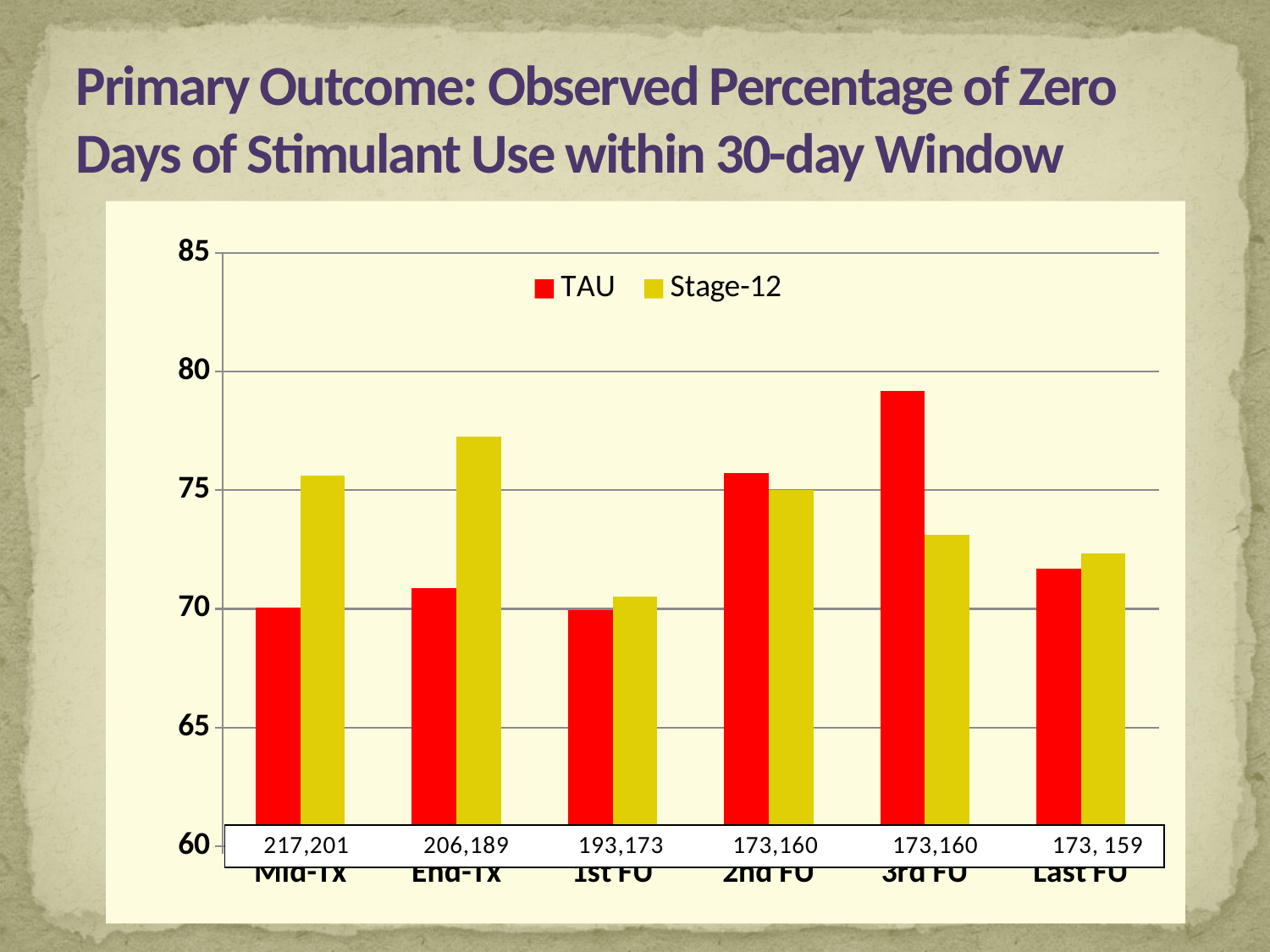
At Mid-Tx, which series has the larger value, TAU or Stage-12? Stage-12 What kind of chart is shown on the slide? Bar chart What are the two series named in the legend? TAU and Stage-12 At which time point is the Stage-12 value highest? End-Tx How many time-point categories are shown on the x axis? 6 At which time point is the Stage-12 value lowest? 1st FU How many series does the legend list? 2 Which series is shown in red? TAU At which time point is the TAU value highest? 3rd FU